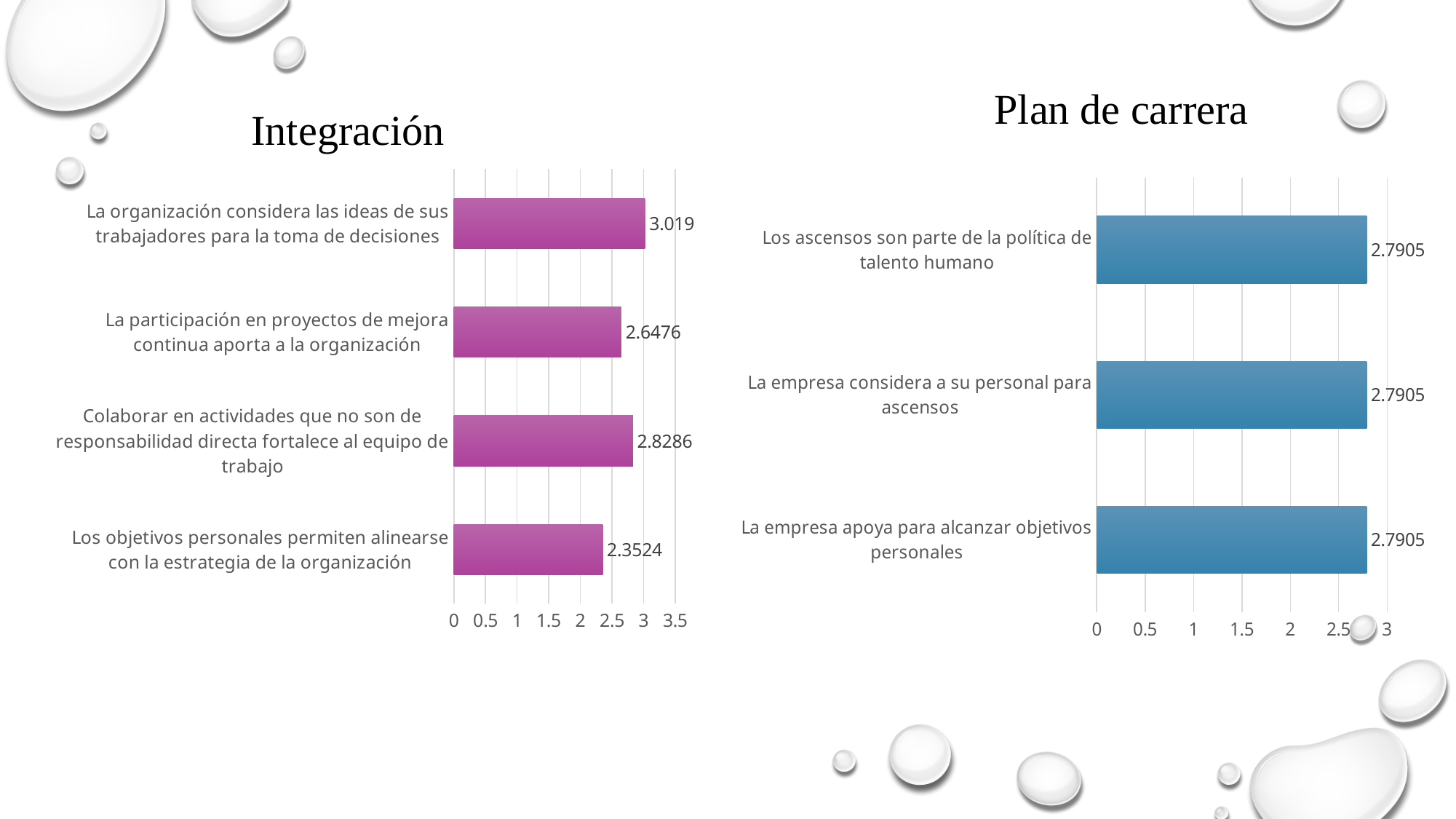
How many categories are shown in the Plan de carrera chart? 3 In the Integración chart, what is the value for "La organización considera las ideas de sus trabajadores para la toma de decisiones"? 3.019 What type of chart is the Plan de carrera chart? Bar chart In the Plan de carrera chart, what is the value for "Los ascensos son parte de la política de talento humano"? 2.7905 In the Integración chart, what is the difference between the values for "Colaborar en actividades que no son de responsabilidad directa fortalece al equipo de trabajo" and "La participación en proyectos de mejora continua aporta a la organización"? 0.181 How many categories are shown in the Integración chart? 4 In the Integración chart, what is the value for "Los objetivos personales permiten alinearse con la estrategia de la organización"? 2.3524 In the Integración chart, which category has the highest value? La organización considera las ideas de sus trabajadores para la toma de decisiones In the Integración chart, is the value for "La organización considera las ideas de sus trabajadores para la toma de decisiones" greater or less than 3? greater What is the title of the chart on the left side of the slide? Integración In the Integración chart, which is larger: the value for "La participación en proyectos de mejora continua aporta a la organización" or the value for "Los objetivos personales permiten alinearse con la estrategia de la organización"? La participación en proyectos de mejora continua aporta a la organización In the Integración chart, which category has the lowest value? Los objetivos personales permiten alinearse con la estrategia de la organización